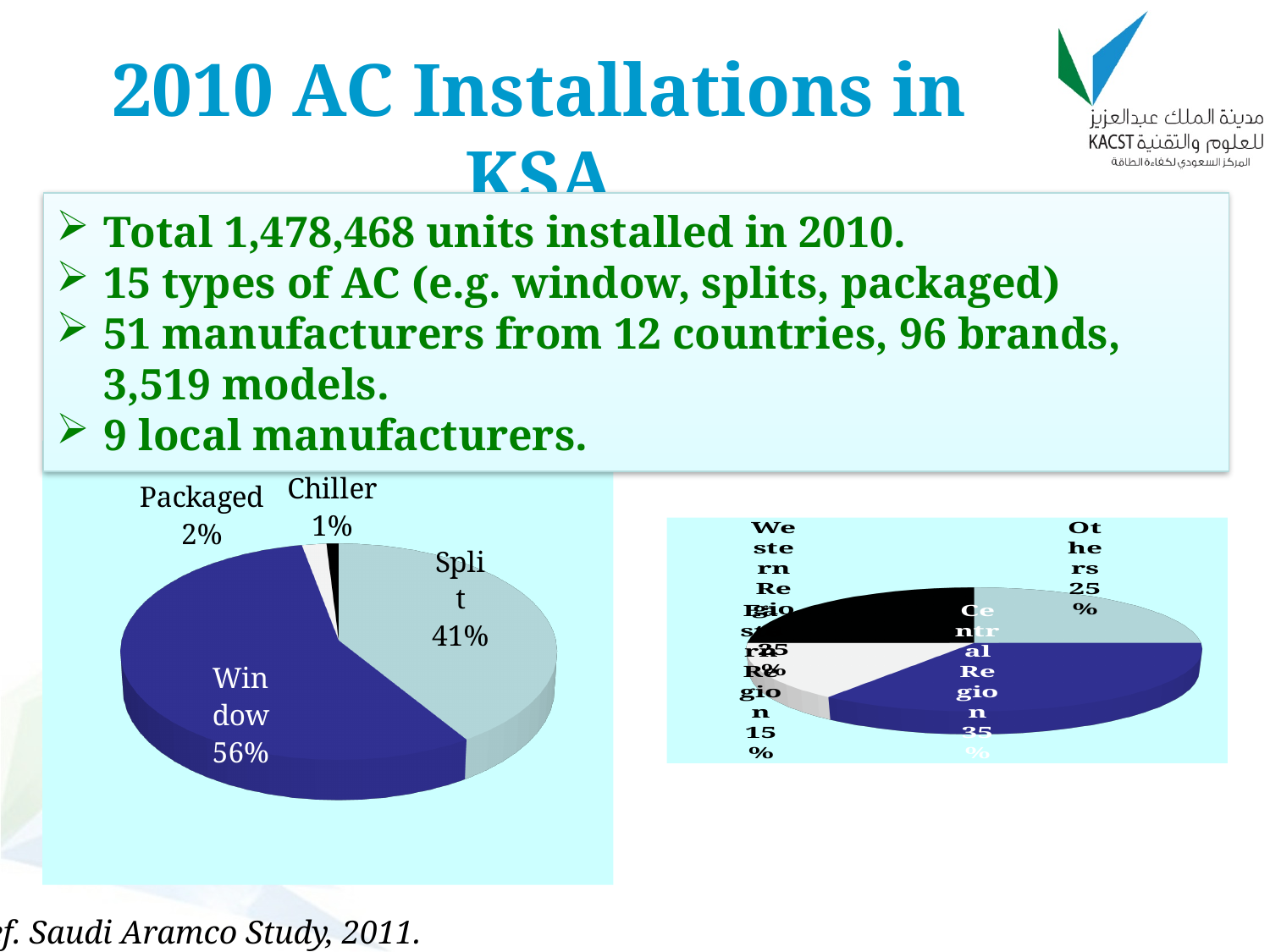
On the right pie chart, what share is Others? 25% On the left pie chart, what share of installations is Window? 56% On the left pie chart, what share is Chiller? 1% On the left pie chart, which is larger, Packaged or Chiller? Packaged What type of chart is the left chart on the slide? Pie chart On the left pie chart, what share is Packaged? 2% On the left pie chart, how many percentage points larger is Window than Split? 15 On the left pie chart, which category has the smallest share? Chiller On the left pie chart, which category has the largest share? Window On the right pie chart, what share is Central Region? 35% On the left pie chart, what share of installations is Split? 41% How many categories does the left pie chart show? 4